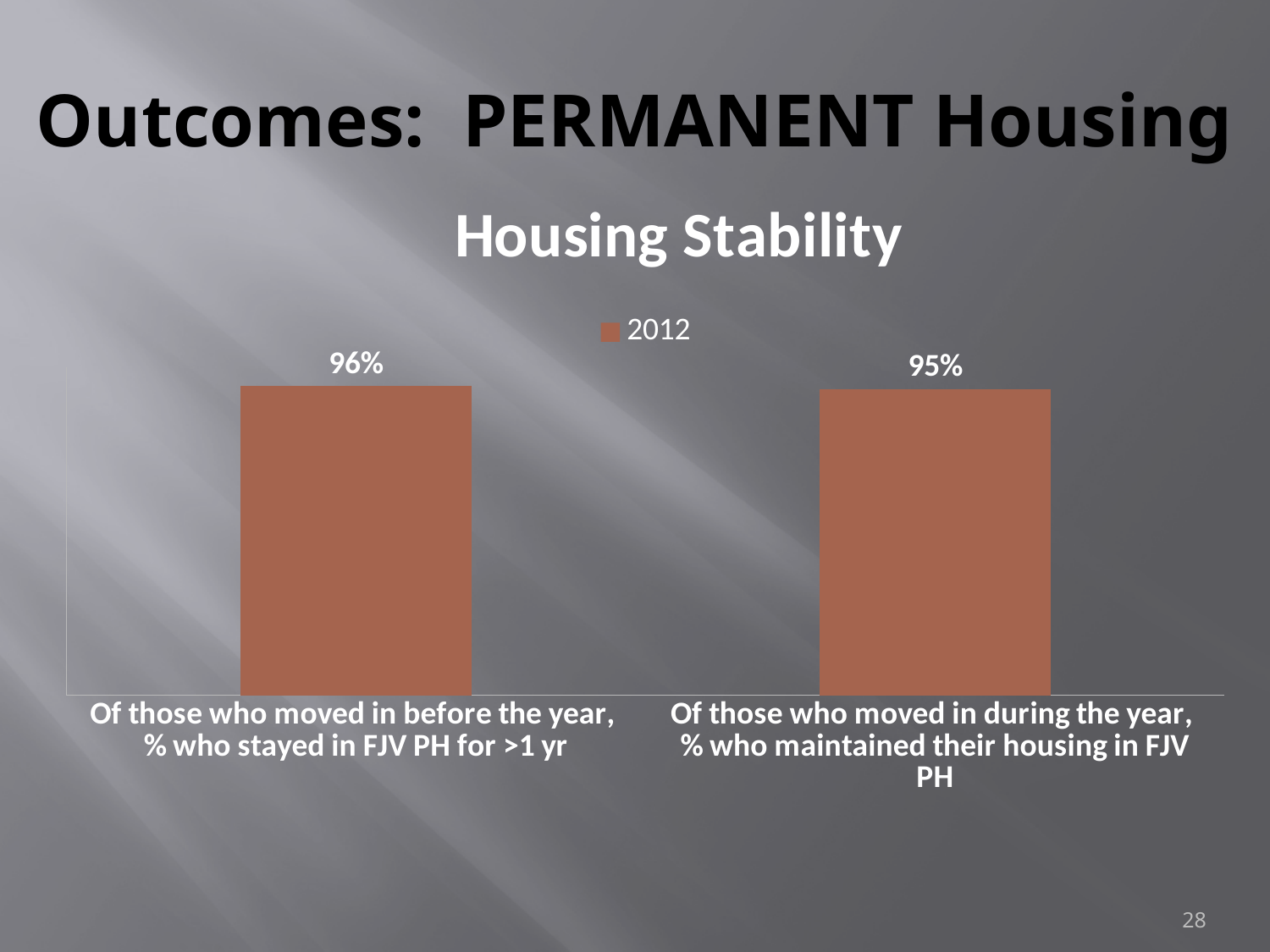
How many categories are shown in the chart? 2 What is the value for 'Of those who moved in during the year, % who maintained their housing in FJV PH'? 95% Which category has the lowest value? Of those who moved in during the year, % who maintained their housing in FJV PH How many series does the legend list? 1 What is the difference between the two bars' values? 1% What is the value for 'Of those who moved in before the year, % who stayed in FJV PH for >1 yr'? 96% What kind of chart is shown? Bar chart What series name appears in the legend? 2012 Which category has the highest value? Of those who moved in before the year, % who stayed in FJV PH for >1 yr What is the title of the chart? Housing Stability